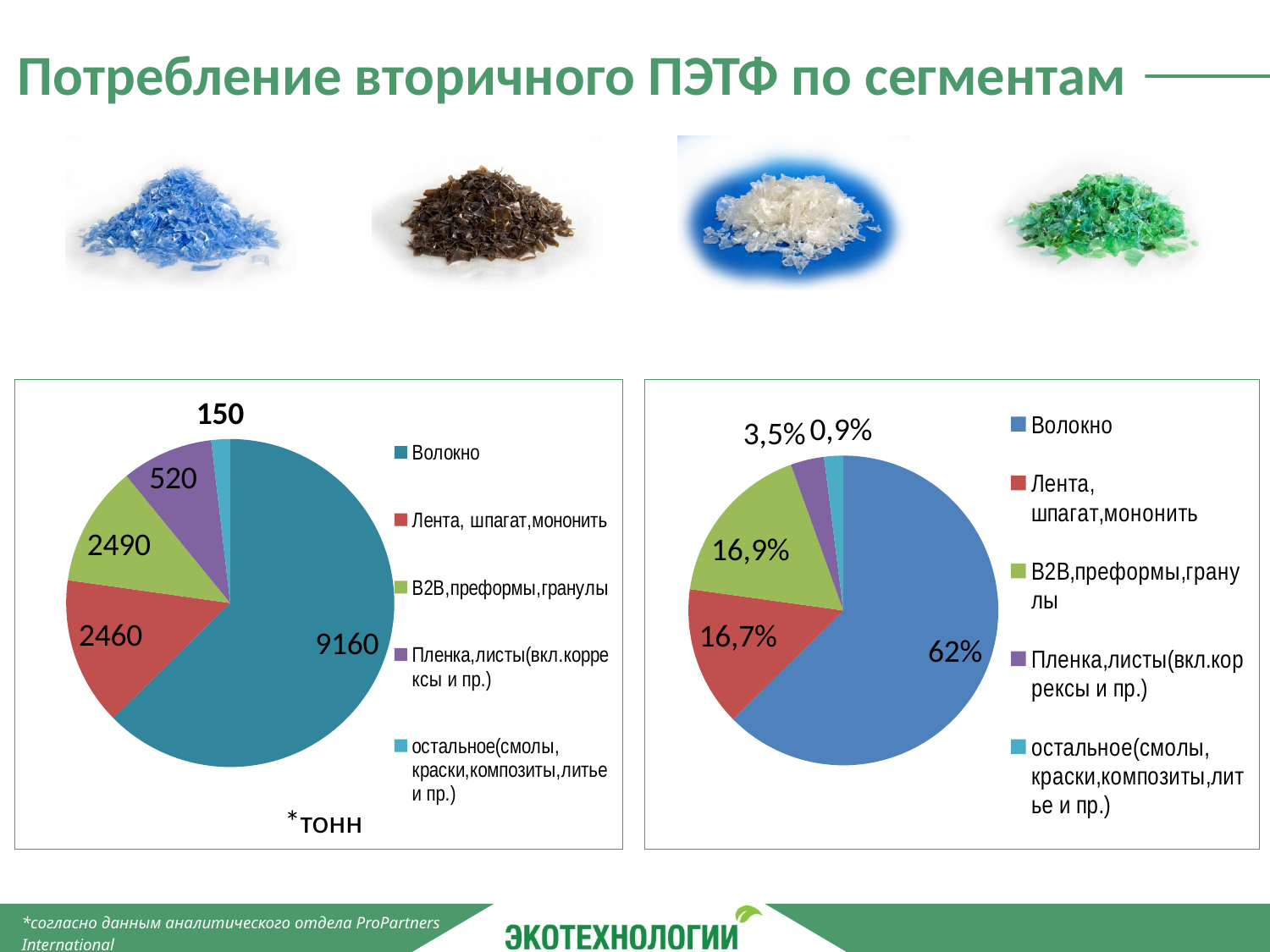
How many categories does the right pie chart show? 5 In the right pie chart, what share does B2B,преформы,гранулы have? 16,9% What type of chart is shown on the left side of the slide? Pie chart In the right pie chart, what share does Лента, шпагат,мононить have? 16,7% In the left pie chart, what is the difference between the values for Волокно and Лента, шпагат,мононить? 6700 In the left pie chart, what is the value for Пленка,листы(вкл.коррексы и пр.)? 520 In the left pie chart, what is the value for Волокно? 9160 In the right pie chart, which category has the smallest share? остальное(смолы, краски,композиты,литье и пр.) In the right pie chart, what share does Волокно have? 62% In the left pie chart, which is larger: the value for Волокно or the value for Лента, шпагат,мононить? Волокно In the left pie chart, what is the value for остальное(смолы, краски,композиты,литье и пр.)? 150 In the left pie chart, which category has the largest value? Волокно